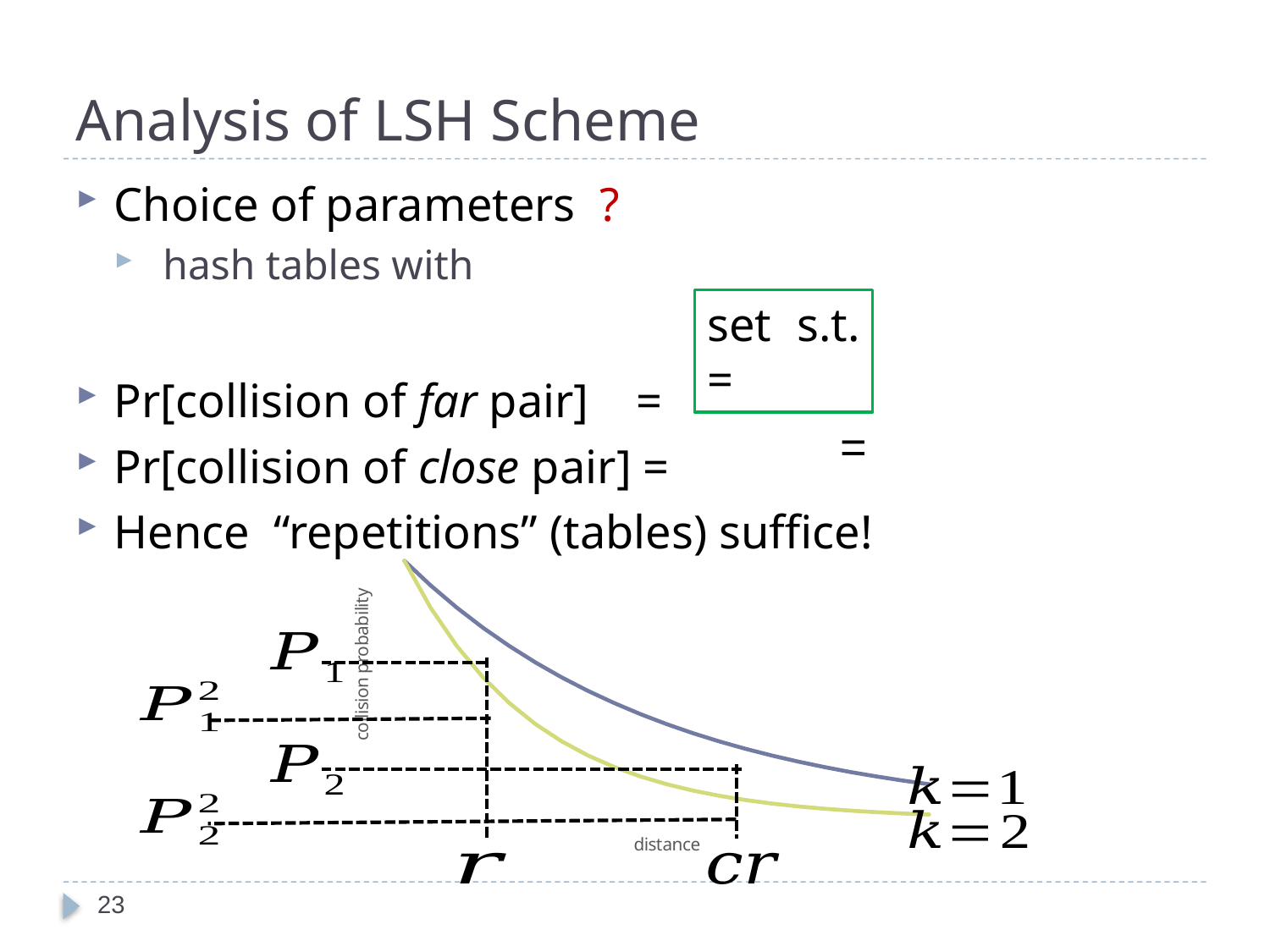
What are the two curves in the chart labelled? k=1 and k=2 Which curve is higher at distance r, k=1 or k=2? k=1 Do the curves rise or fall as distance increases along the x axis? fall Which curve has the lower collision probability at every distance shown, k=1 or k=2? k=2 Which is larger, the collision probability at distance r or at distance cr on the k=1 curve? at distance r Which curve is higher at distance cr, k=1 or k=2? k=1 What kind of chart is shown at the bottom of the slide? line chart How many curves are plotted in the chart? 2 What is the label of the vertical axis of the chart? collision probability